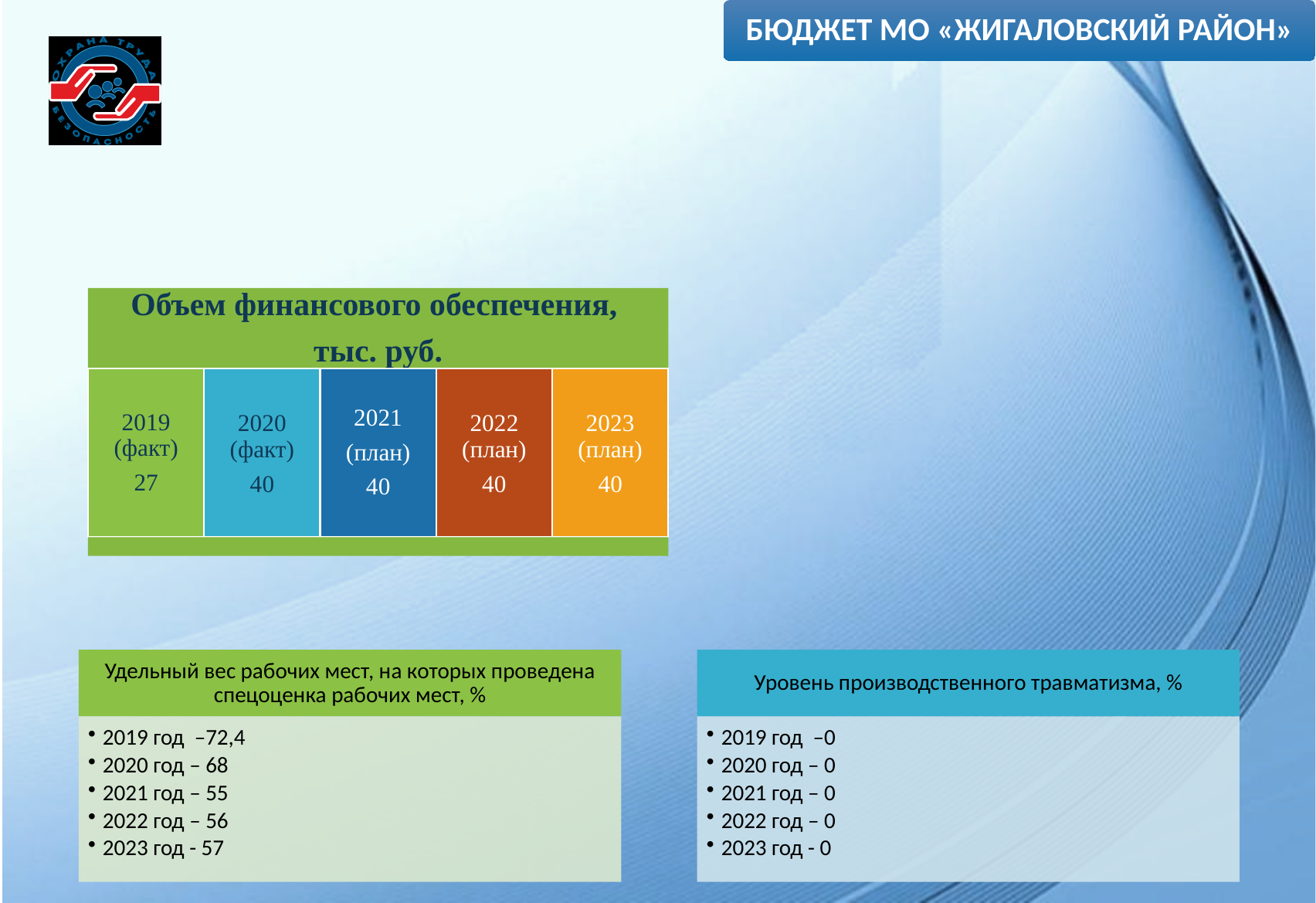
How many years are shown in the "Объем финансового обеспечения, тыс. руб." graphic? 5 In the "Объем финансового обеспечения, тыс. руб." graphic, how many years have a value of 40? 4 In the "Объем финансового обеспечения, тыс. руб." graphic, what is the value for 2020 (факт)? 40 In the "Объем финансового обеспечения, тыс. руб." graphic, what is the value for 2023 (план)? 40 In the "Объем финансового обеспечения, тыс. руб." graphic, how many years are marked as (план)? 3 In the "Объем финансового обеспечения, тыс. руб." graphic, which is larger: the value for 2019 (факт) or for 2021 (план)? 2021 (план) In the "Объем финансового обеспечения, тыс. руб." graphic, what colour is the 2023 (план) block? orange What is the title of the graphic showing values for 2019 to 2023 on the slide? Объем финансового обеспечения, тыс. руб. In the "Объем финансового обеспечения, тыс. руб." graphic, what is the difference between the 2020 (факт) value and the 2019 (факт) value? 13 In the "Объем финансового обеспечения, тыс. руб." graphic, which year has the lowest value? 2019 (факт) In the "Объем финансового обеспечения, тыс. руб." graphic, does the value rise or fall from 2019 (факт) to 2020 (факт)? rises In the "Объем финансового обеспечения, тыс. руб." graphic, what is the value for 2019 (факт)? 27